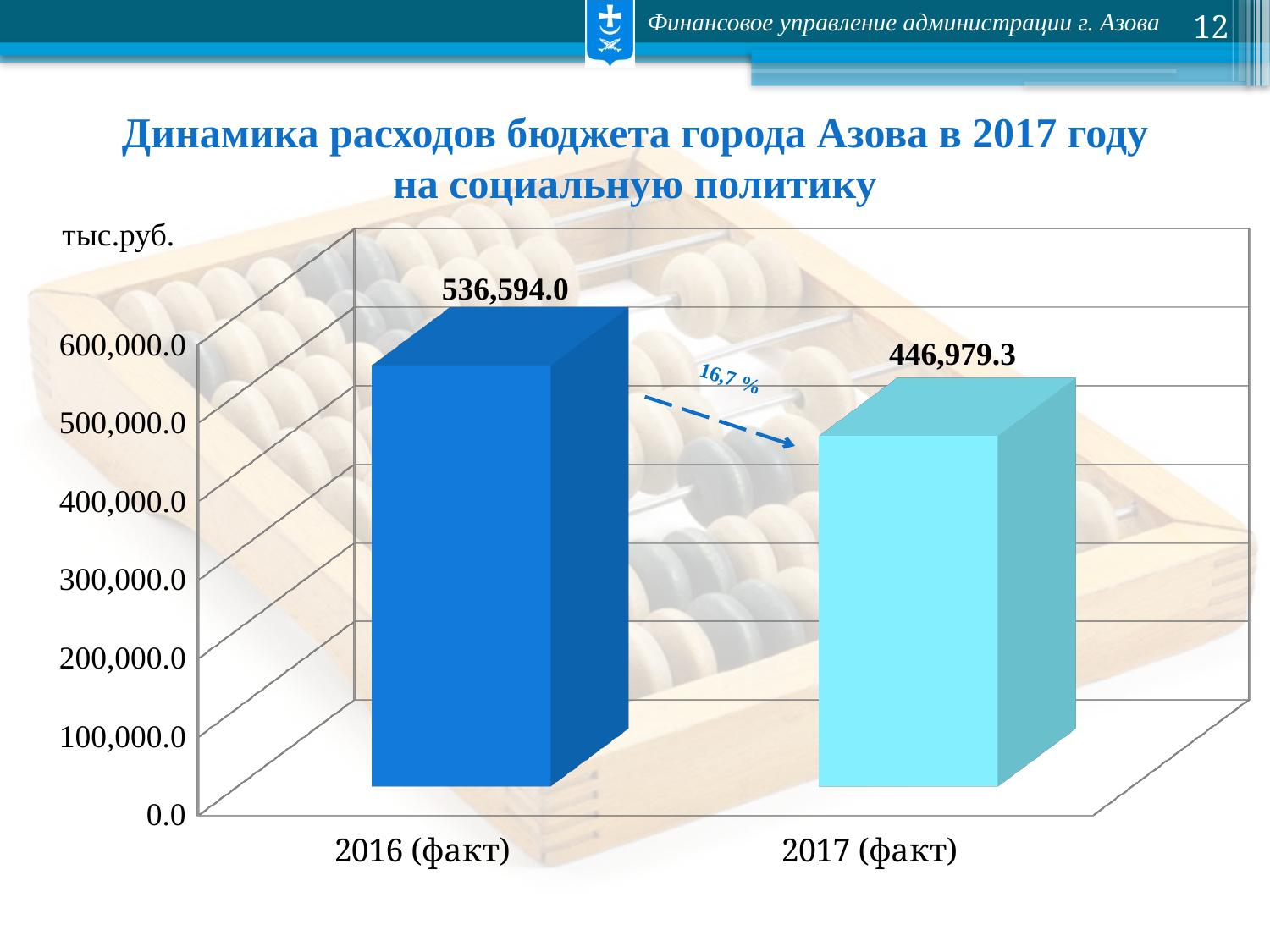
Which category has the highest value? 2016 (факт) Do the values rise or fall from 2016 (факт) to 2017 (факт)? fall Which category has the lowest value? 2017 (факт) What kind of chart is shown on the slide? bar chart What is the difference between the values for 2016 (факт) and 2017 (факт)? 89,614.7 Is the value for 2017 (факт) greater or less than 500,000.0? less How many categories are shown on the chart? 2 What is the value for 2016 (факт)? 536,594.0 Which is larger, the value for 2016 (факт) or for 2017 (факт)? 2016 (факт) What percentage change is written next to the arrow between the two bars? 16,7 % What is the value for 2017 (факт)? 446,979.3 Is the value for 2016 (факт) greater or less than 500,000.0? greater